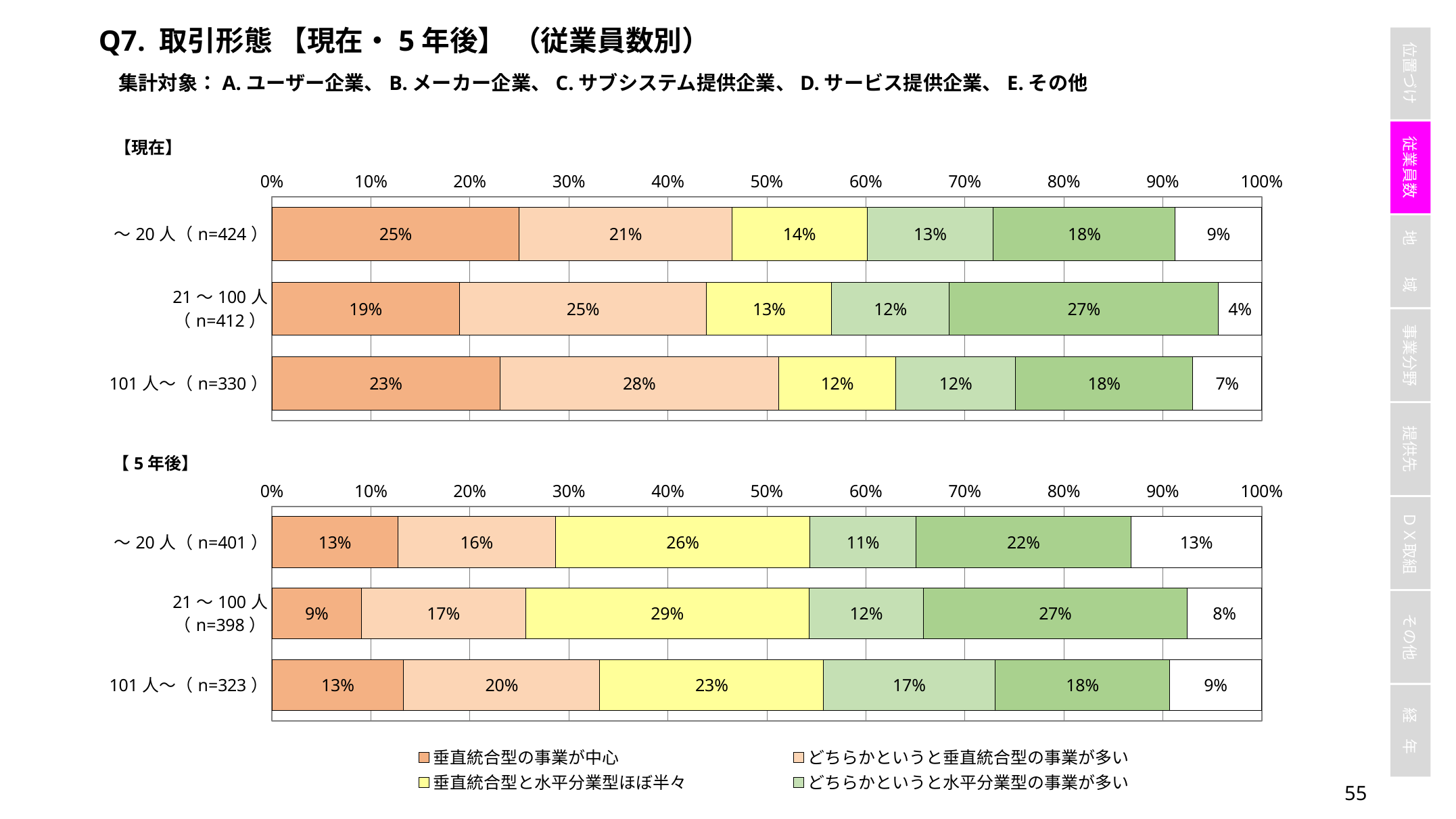
In the 【5年後】 chart, which employee-size category has the lowest value for 垂直統合型の事業が中心? 21～100人（n=398） What kind of chart is the 【5年後】 chart? Stacked bar chart In the 【現在】 chart, which employee-size category has the highest value for 垂直統合型の事業が中心? ～20人（n=424） In the 【現在】 chart, what is the combined value of 垂直統合型の事業が中心 and どちらかというと垂直統合型の事業が多い for 21～100人（n=412）? 44% How many series does the legend at the bottom of the slide list? 4 In the 【5年後】 chart, what is the value of どちらかというと水平分業型の事業が多い for 101人～（n=323）? 17% In the 【5年後】 chart, which is larger for ～20人（n=401）: 垂直統合型の事業が中心 or 垂直統合型と水平分業型ほぼ半々? 垂直統合型と水平分業型ほぼ半々 In the 【現在】 chart, what is the value of どちらかというと垂直統合型の事業が多い for 101人～（n=330）? 28% How many employee-size categories are shown in the 【現在】 chart? 3 In the 【現在】 chart, what is the difference between the どちらかというと垂直統合型の事業が多い values for 101人～（n=330） and ～20人（n=424）? 7% In the 【現在】 chart, what is the value of 垂直統合型の事業が中心 for ～20人（n=424）? 25% In the 【5年後】 chart, what is the value of 垂直統合型と水平分業型ほぼ半々 for 21～100人（n=398）? 29%